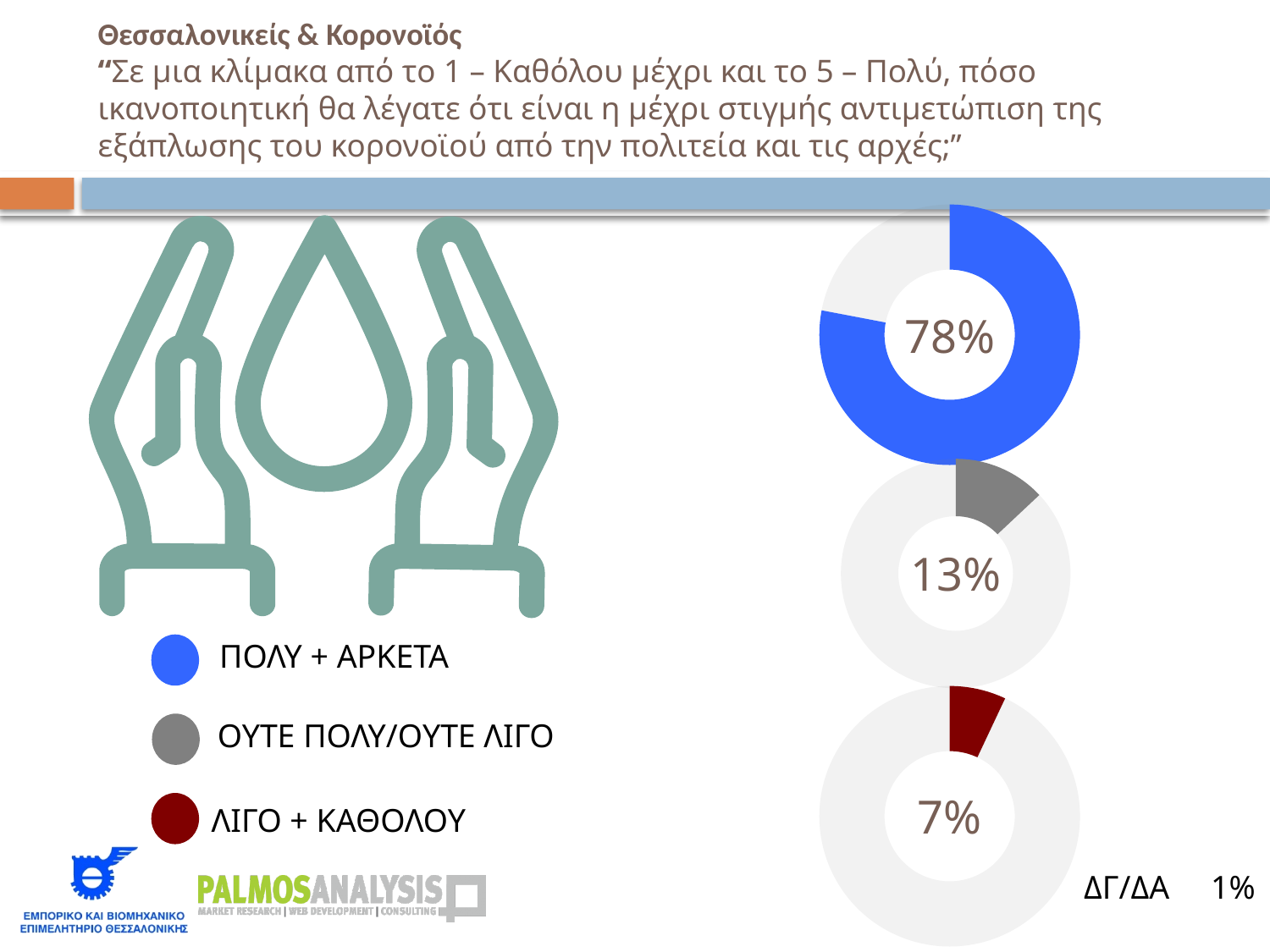
Which is larger: the percentage for ΟΥΤΕ ΠΟΛΥ/ΟΥΤΕ ΛΙΓΟ or for ΛΙΓΟ + ΚΑΘΟΛΟΥ? ΟΥΤΕ ΠΟΛΥ/ΟΥΤΕ ΛΙΓΟ What colour represents ΛΙΓΟ + ΚΑΘΟΛΟΥ in the legend? Dark red What is the difference in percentage points between ΠΟΛΥ + ΑΡΚΕΤΑ and ΟΥΤΕ ΠΟΛΥ/ΟΥΤΕ ΛΙΓΟ? 65 How many donut charts are shown on the slide? 3 What percentage is shown for ΠΟΛΥ + ΑΡΚΕΤΑ (the blue donut)? 78% What type of chart is used to display the percentages on the right of the slide? Donut chart What percentage is given for ΔΓ/ΔΑ on the slide? 1% Which of the three donut charts shows the lowest percentage? ΛΙΓΟ + ΚΑΘΟΛΟΥ What percentage is shown for ΛΙΓΟ + ΚΑΘΟΛΟΥ (the dark red donut)? 7% What is the difference in percentage points between ΟΥΤΕ ΠΟΛΥ/ΟΥΤΕ ΛΙΓΟ and ΛΙΓΟ + ΚΑΘΟΛΟΥ? 6 What percentage is shown for ΟΥΤΕ ΠΟΛΥ/ΟΥΤΕ ΛΙΓΟ (the grey donut)? 13% Which response category has the highest percentage? ΠΟΛΥ + ΑΡΚΕΤΑ